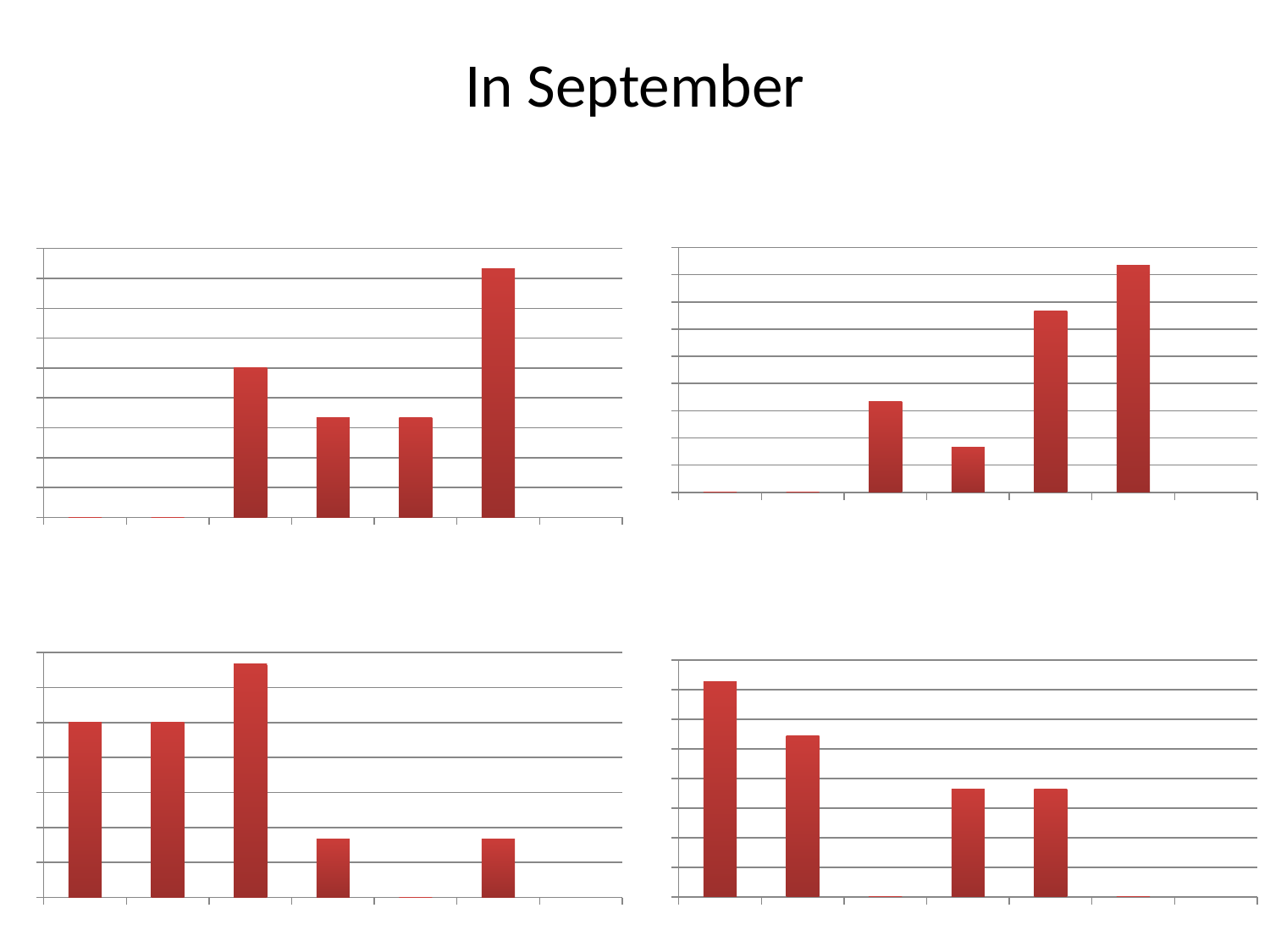
In the bottom-right chart, do the bar heights generally rise or fall from left to right? fall In the bottom-left chart, which bar is taller: the third bar from the left or the fourth bar from the left? the third bar from the left What is the title of the slide? In September In the top-right chart, is the tallest bar the leftmost or the rightmost of the plotted bars? the rightmost In the bottom-right chart, is the tallest bar the leftmost or the rightmost of the plotted bars? the leftmost How many charts are shown on the slide? 4 How many bars are plotted in the top-right chart? 4 How many bars are plotted in the bottom-right chart? 4 What kind of chart is the bottom-right chart on the slide? bar chart In the top-left chart, which bar is the tallest: the leftmost bar or the rightmost bar? the rightmost bar How many bars are plotted in the top-left chart? 4 What kind of chart is the top-left chart on the slide? bar chart